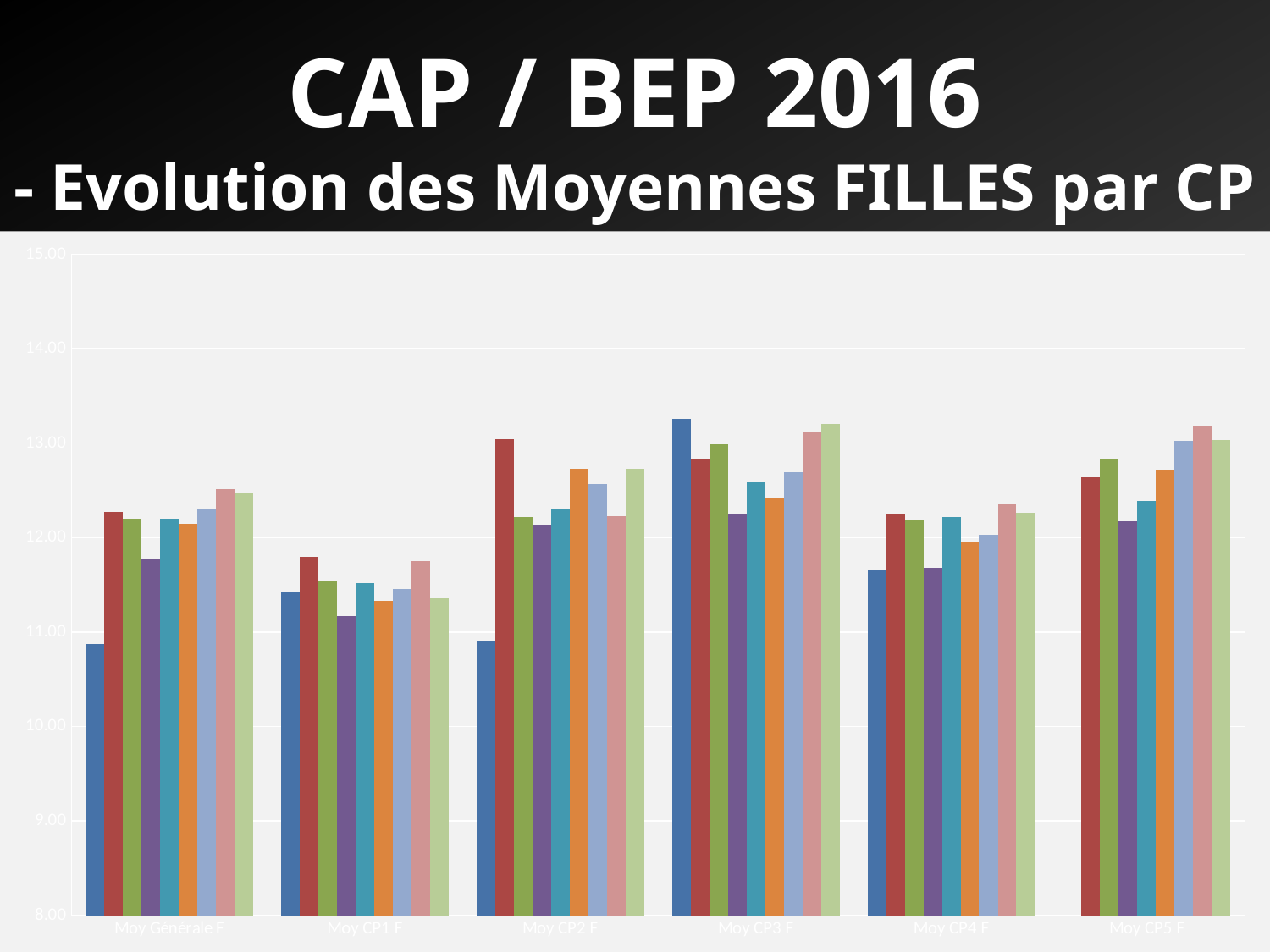
Is the value of the second (red) bar for Moy CP1 F greater or less than 12.00? less Is the value of the first (dark blue) bar for Moy CP4 F greater or less than 12.00? less Are all the bars for Moy CP1 F greater or less than 12.00? less Which is larger: the second (red) bar for Moy CP1 F or the second (red) bar for Moy CP3 F? Moy CP3 F What is the title shown above the chart? CAP / BEP 2016 - Evolution des Moyennes FILLES par CP Which is larger: the first (dark blue) bar for Moy CP3 F or the first (dark blue) bar for Moy Générale F? Moy CP3 F Which category contains the tallest bar in the chart? Moy CP3 F What kind of chart is shown on the slide? bar chart How many categories are shown on the x axis of the chart? 6 What is the label of the first category on the x axis? Moy Générale F